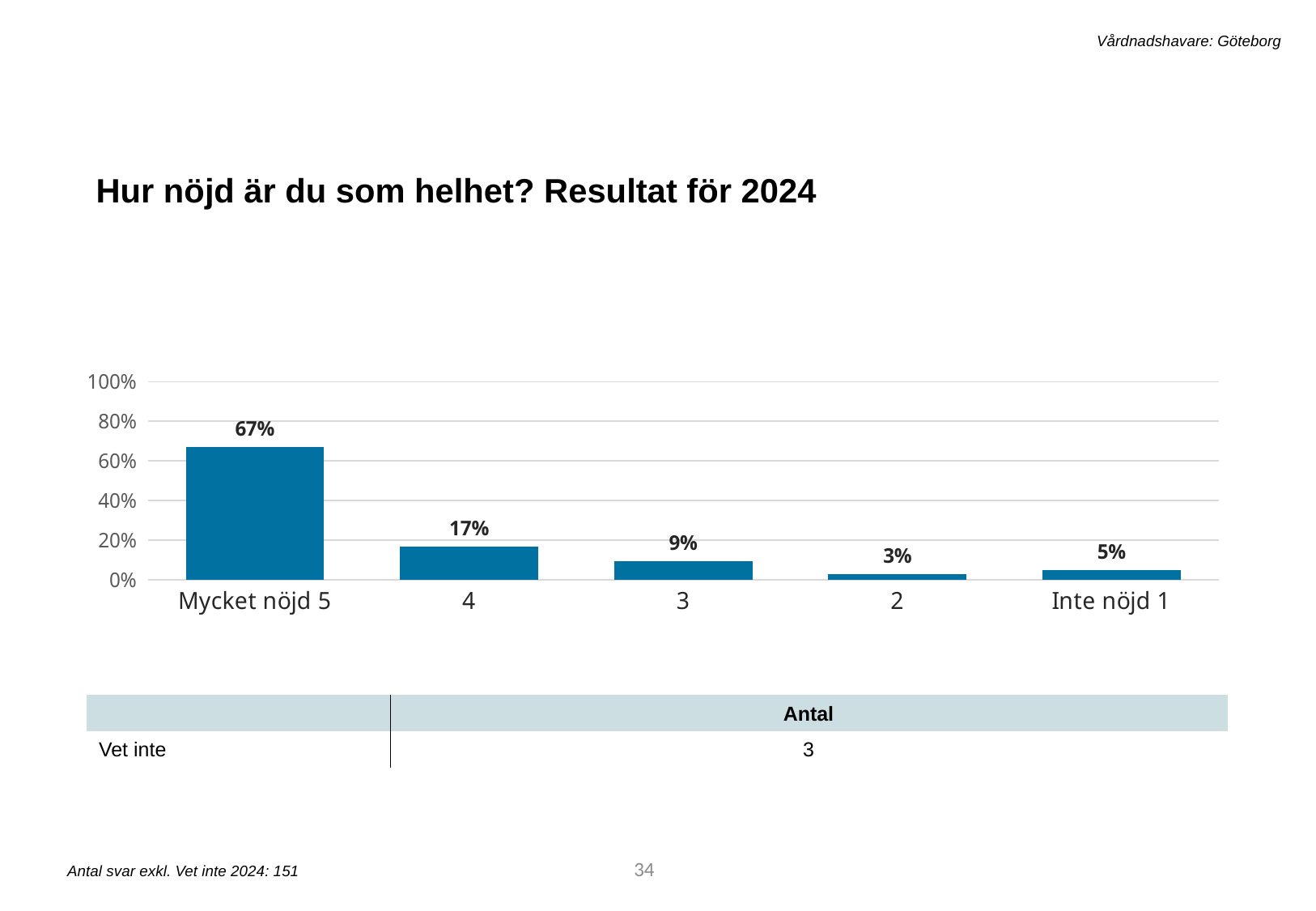
What is the title of the slide above the chart? Hur nöjd är du som helhet? Resultat för 2024 What is the value for "Mycket nöjd 5"? 67% What is the value for "Inte nöjd 1"? 5% Which category has the highest value? Mycket nöjd 5 How many categories are shown on the x axis? 5 What kind of chart is shown on the slide? bar chart Which category has the lowest value? 2 What is the value for category "4"? 17% Is the value for "Mycket nöjd 5" greater or less than 60%? greater What is the difference between the values for "Mycket nöjd 5" and "4"? 50% Which is larger, the value for "2" or the value for "Inte nöjd 1"? Inte nöjd 1 What is the value for category "3"? 9%